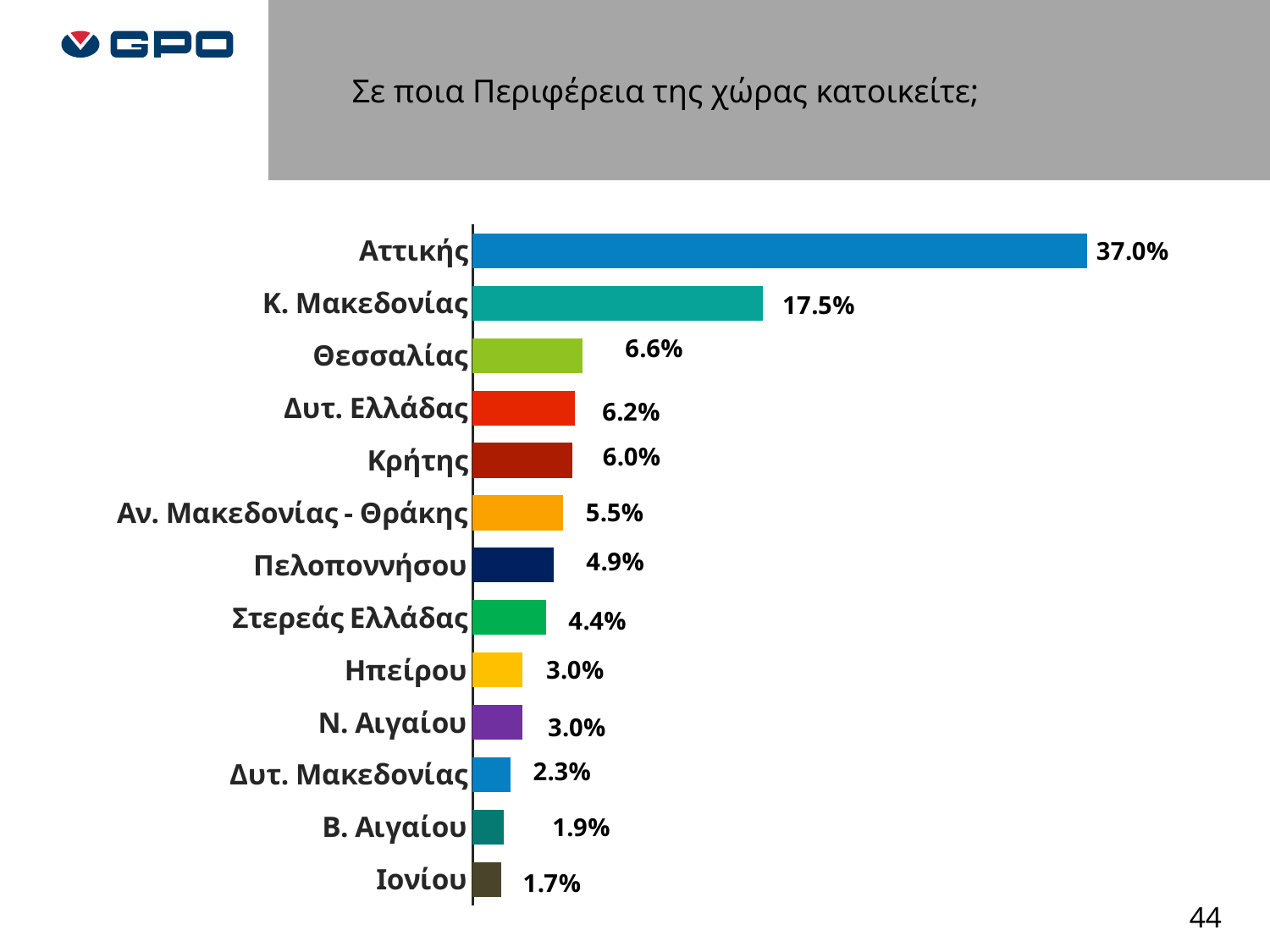
What is the difference between the values for Θεσσαλίας and Δυτ. Ελλάδας? 0.4% Which region has the lowest value? Ιονίου What is the value for Ιονίου? 1.7% Which region has the highest value? Αττικής What kind of chart is shown on the slide? bar chart What is the title of the chart? Σε ποια Περιφέρεια της χώρας κατοικείτε; What is the value for Αττικής? 37.0% What is the value for Κ. Μακεδονίας? 17.5% How many regions are shown in the chart? 13 What is the value for Κρήτης? 6.0% Which is larger, the value for Πελοποννήσου or the value for Στερεάς Ελλάδας? Πελοποννήσου What is the difference between the values for Αττικής and Κ. Μακεδονίας? 19.5%